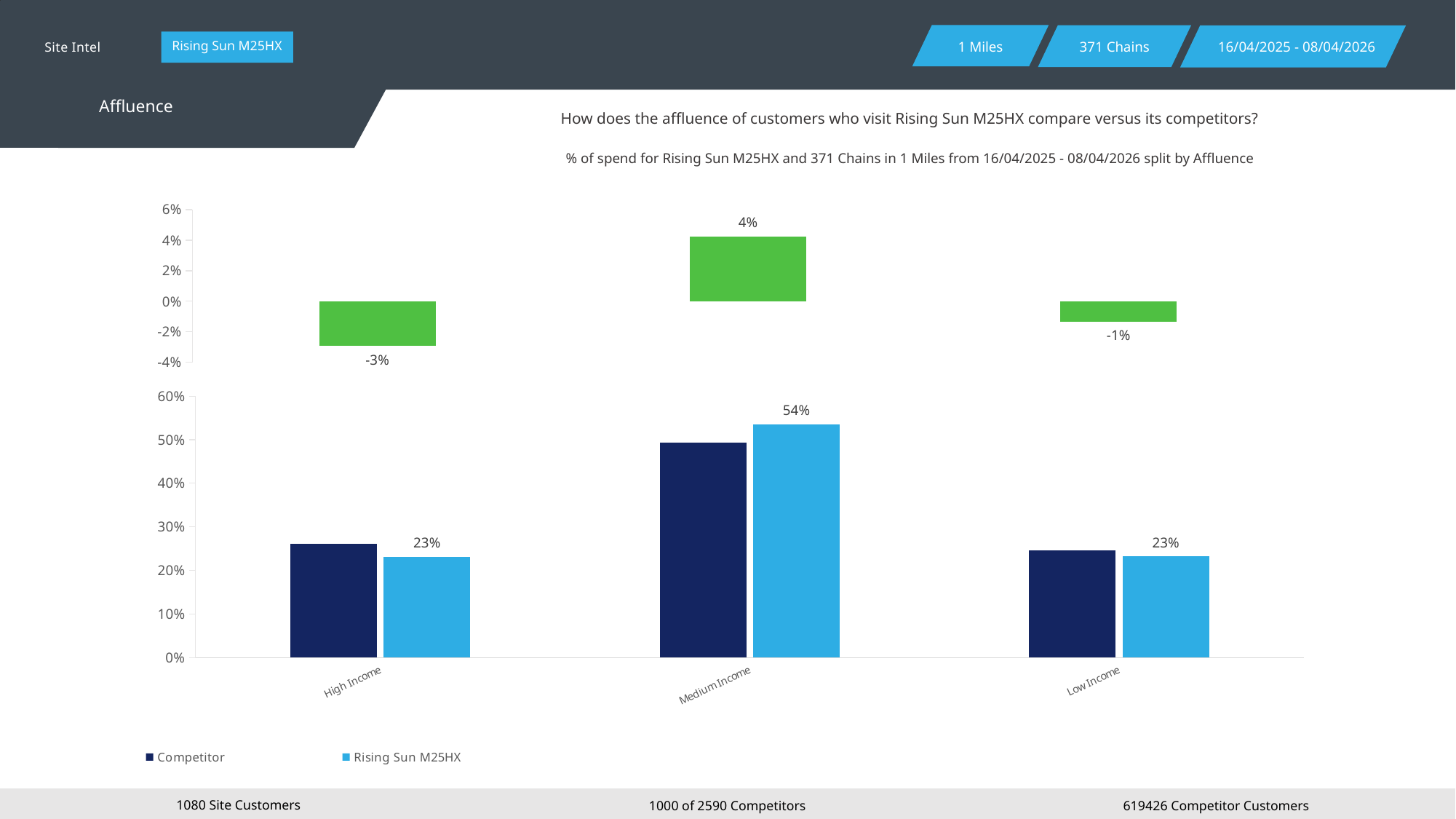
In the top chart, which category has the highest value? Medium Income In the bottom chart, what is the Rising Sun M25HX value for High Income? 23% In the top chart, what is the value for Low Income? -1% In the top chart, which category has the lowest value? High Income In the bottom chart, is the Competitor value for Medium Income greater or less than 40%? greater How many series does the legend of the bottom chart list? 2 In the top chart, what is the value for High Income? -3% In the bottom chart, what is the difference between the Rising Sun M25HX values for Medium Income and Low Income? 31% What type of chart is the bottom chart? Bar chart In the bottom chart, which is larger for High Income: Competitor or Rising Sun M25HX? Competitor In the bottom chart, what is the Rising Sun M25HX value for Medium Income? 54% In the top chart, what is the value for Medium Income? 4%